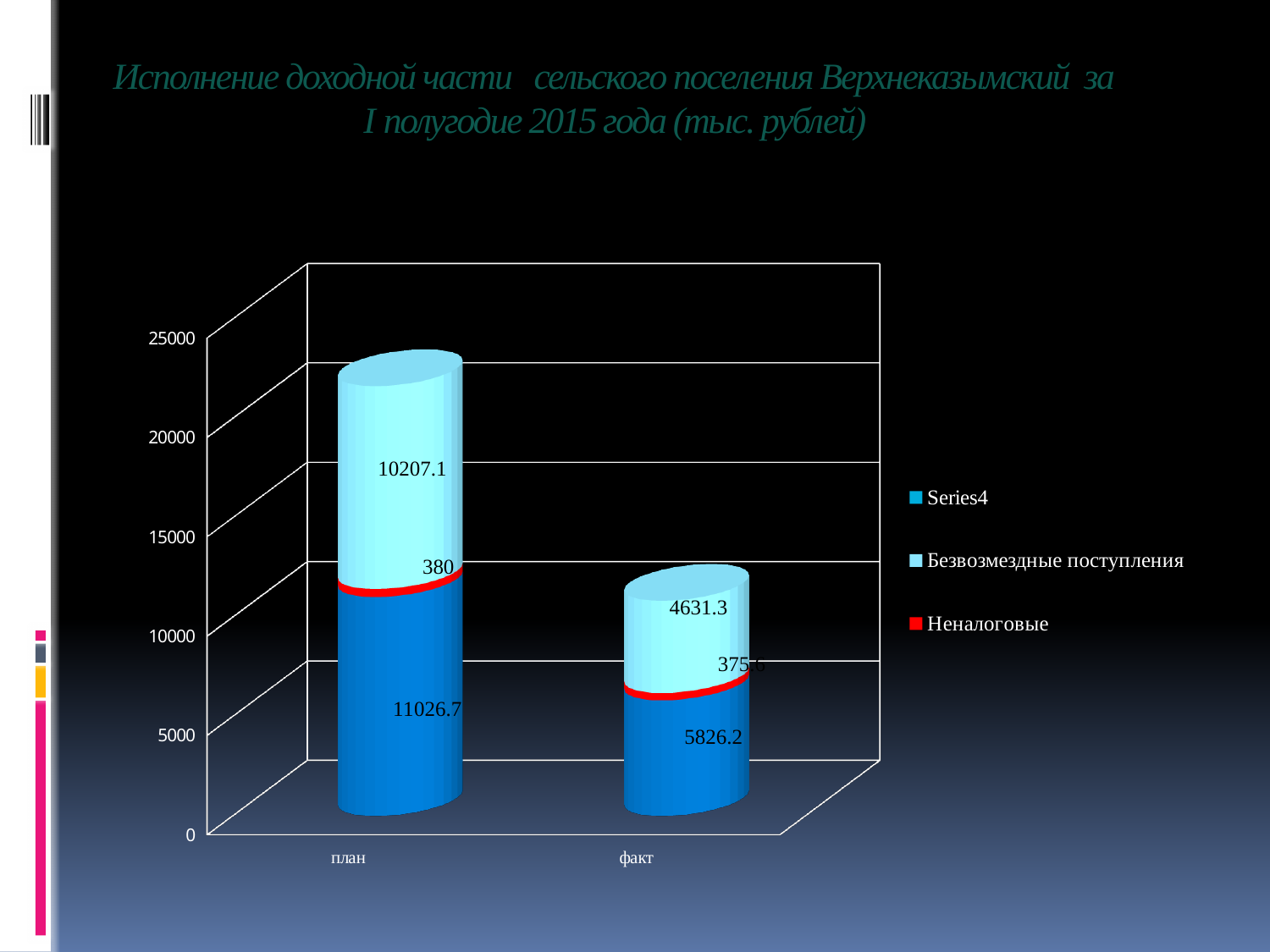
What is the difference between the Безвозмездные поступления values for план and факт? 5575.8 What is the value of Series4 for факт? 5826.2 How many series does the legend list? 3 What is the difference between the Series4 values for план and факт? 5200.5 Which category has the taller stacked bar, план or факт? план What is the total of the stacked bar for план? 21613.8 For план, which is larger: Series4 or Безвозмездные поступления? Series4 What is the value of Безвозмездные поступления for факт? 4631.3 What is the value of Безвозмездные поступления for план? 10207.1 Is the total of the stacked bar for факт greater or less than 15000? less What is the value of Неналоговые for план? 380 What is the value of Series4 for план? 11026.7